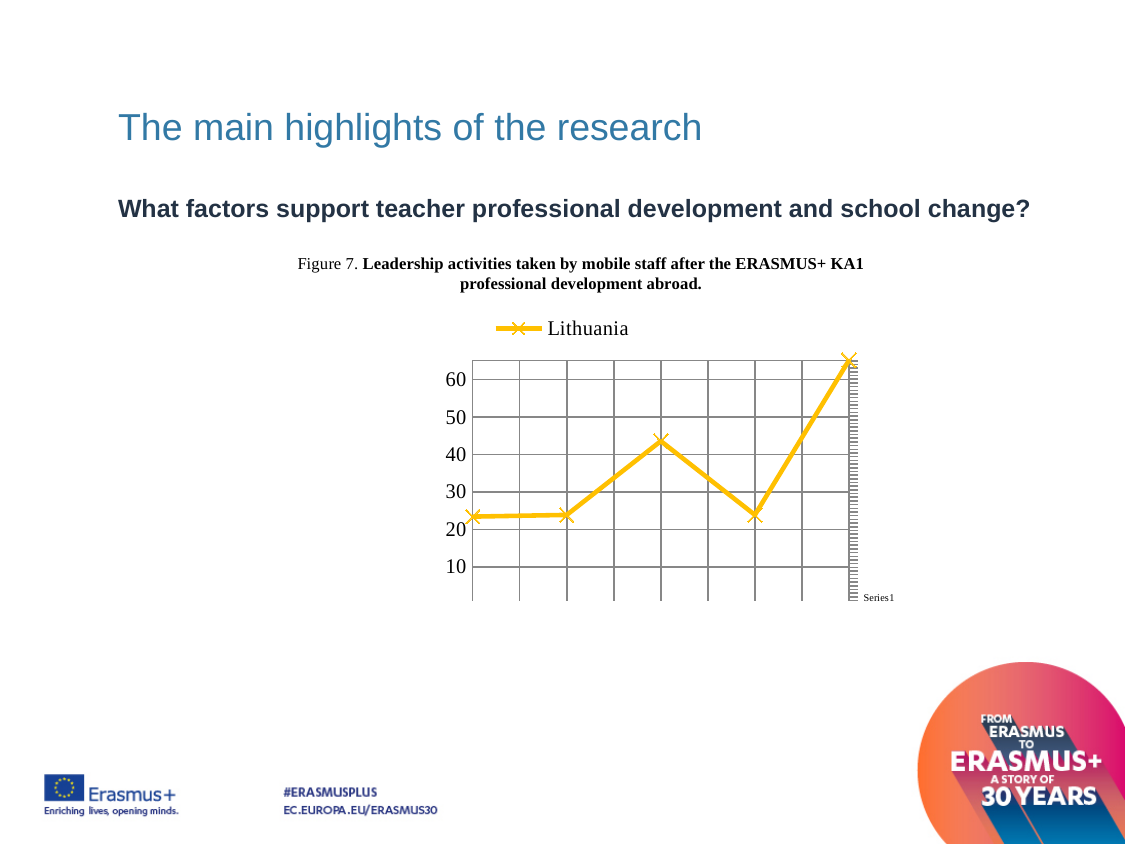
Is the value of the first (leftmost) point greater or less than 30? less How many series does the chart legend list? 1 Is the value of the fourth point greater or less than 30? less Does the line end higher or lower than it starts? higher What colour is the Lithuania line in the chart? yellow/orange What is the name of the series shown in the chart legend? Lithuania Which data point on the line has the highest value? the last (rightmost) point Is the value of the third point greater or less than 40? greater Which is larger, the value of the third point or the value of the fourth point? the third point How many data points are plotted on the line? 5 What kind of chart is shown on the slide? line chart